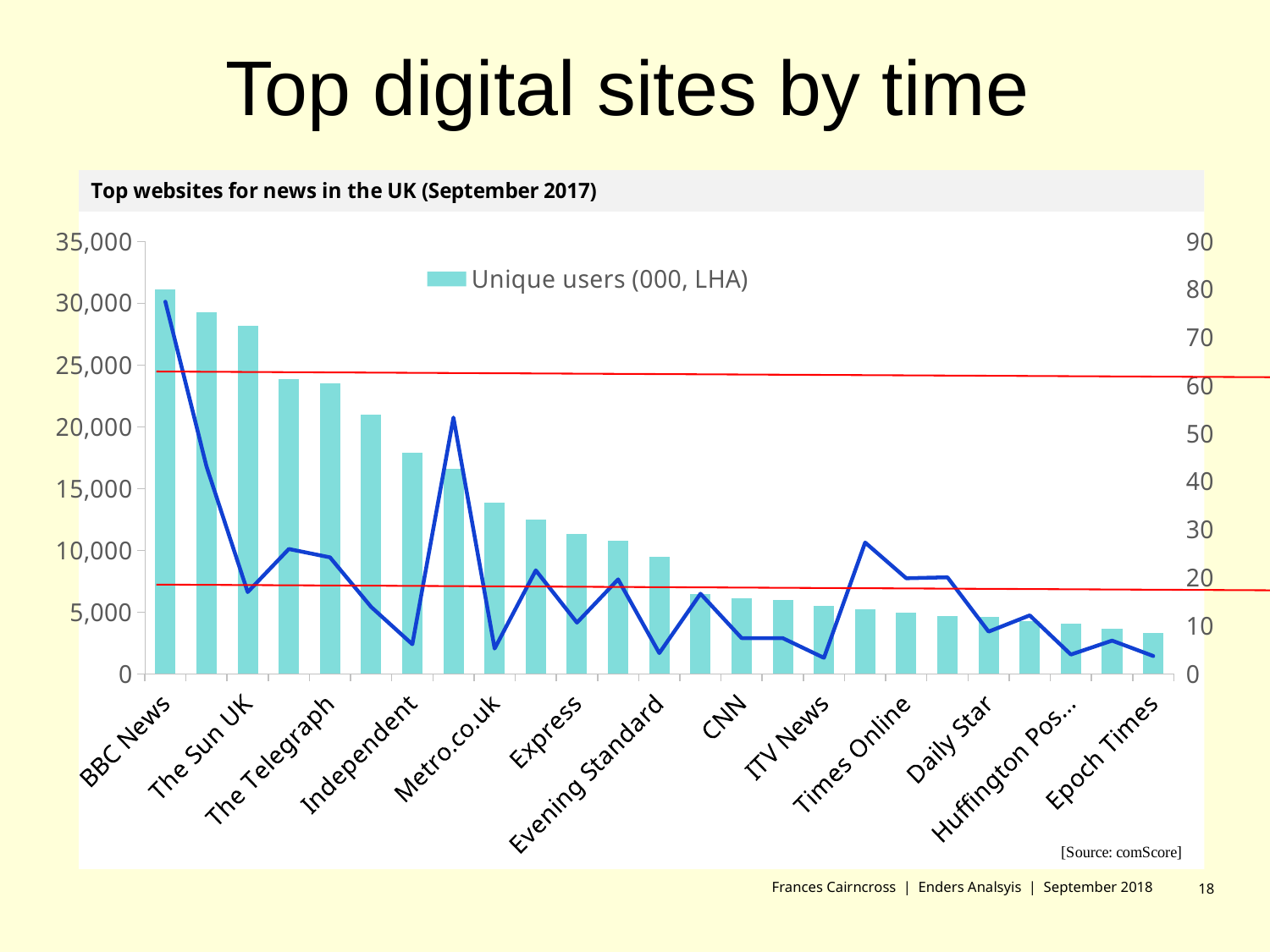
Which website has the highest number of unique users? BBC News What is the title of the chart? Top websites for news in the UK (September 2017) How many series does the legend list? 1 Is the unique users value for BBC News greater or less than 30,000? greater Do the unique users bars rise or fall from left to right across the websites? Fall Is the unique users value for Independent greater or less than 15,000? greater Is the unique users value for Metro.co.uk greater or less than 10,000? greater What kind of chart is used to show unique users? Bar chart (with a line overlaid) Which has more unique users, The Sun UK or CNN? The Sun UK Which website has the lowest number of unique users? Epoch Times